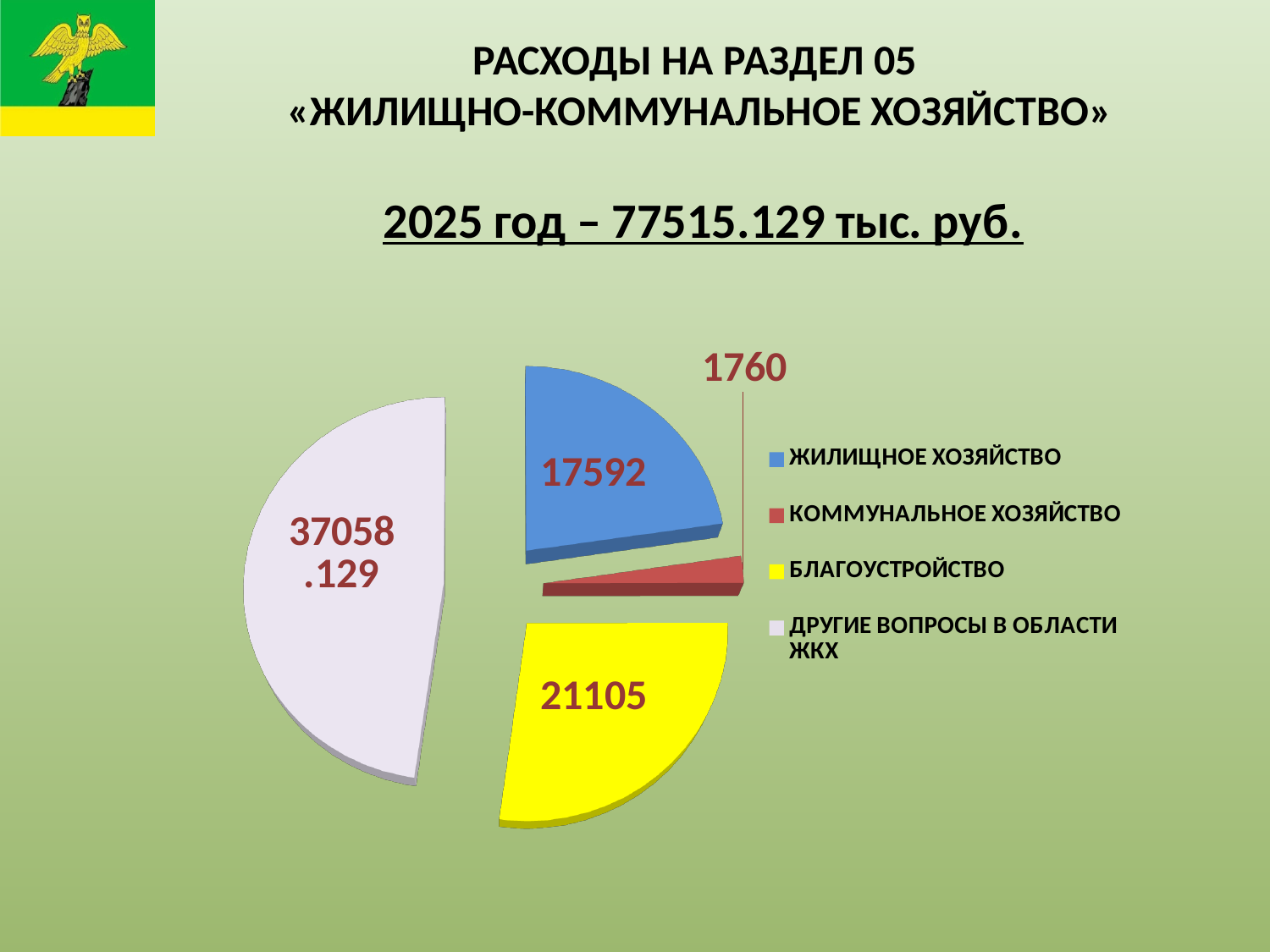
What colour is the slice for БЛАГОУСТРОЙСТВО? yellow What is the difference between the values for ЖИЛИЩНОЕ ХОЗЯЙСТВО and КОММУНАЛЬНОЕ ХОЗЯЙСТВО? 15832 What is the value for КОММУНАЛЬНОЕ ХОЗЯЙСТВО? 1760 What is the value for ДРУГИЕ ВОПРОСЫ В ОБЛАСТИ ЖКХ? 37058.129 Which category has the smallest slice of the pie? КОММУНАЛЬНОЕ ХОЗЯЙСТВО Which category has the largest slice of the pie? ДРУГИЕ ВОПРОСЫ В ОБЛАСТИ ЖКХ What is the value for ЖИЛИЩНОЕ ХОЗЯЙСТВО? 17592 What type of chart is shown on the slide? pie chart Which is larger, БЛАГОУСТРОЙСТВО or ЖИЛИЩНОЕ ХОЗЯЙСТВО? БЛАГОУСТРОЙСТВО What is the difference between the values for БЛАГОУСТРОЙСТВО and ЖИЛИЩНОЕ ХОЗЯЙСТВО? 3513 How many categories does the legend list? 4 What is the value for БЛАГОУСТРОЙСТВО? 21105